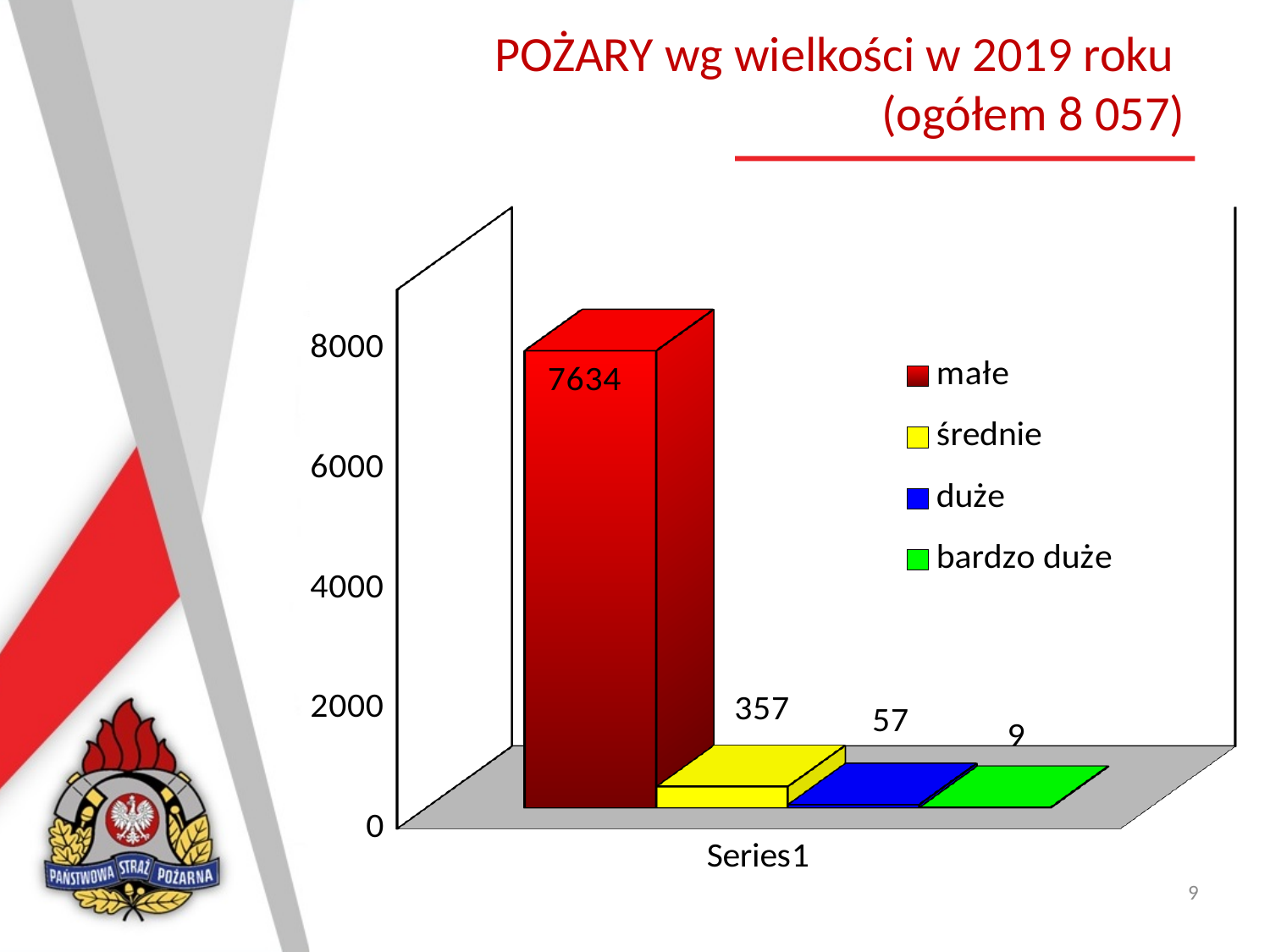
Is the value for małe greater or less than 6000? greater What is the value for bardzo duże? 9 Which is larger, the value for duże or the value for bardzo duże? duże What is the difference between the values for średnie and duże? 300 What is the value for duże? 57 How many categories does the legend list? 4 What is the value for średnie? 357 Which category has the highest value? małe What is the difference between the values for małe and średnie? 7277 What kind of chart is shown on the slide? bar chart Which category has the lowest value? bardzo duże What is the value for małe? 7634